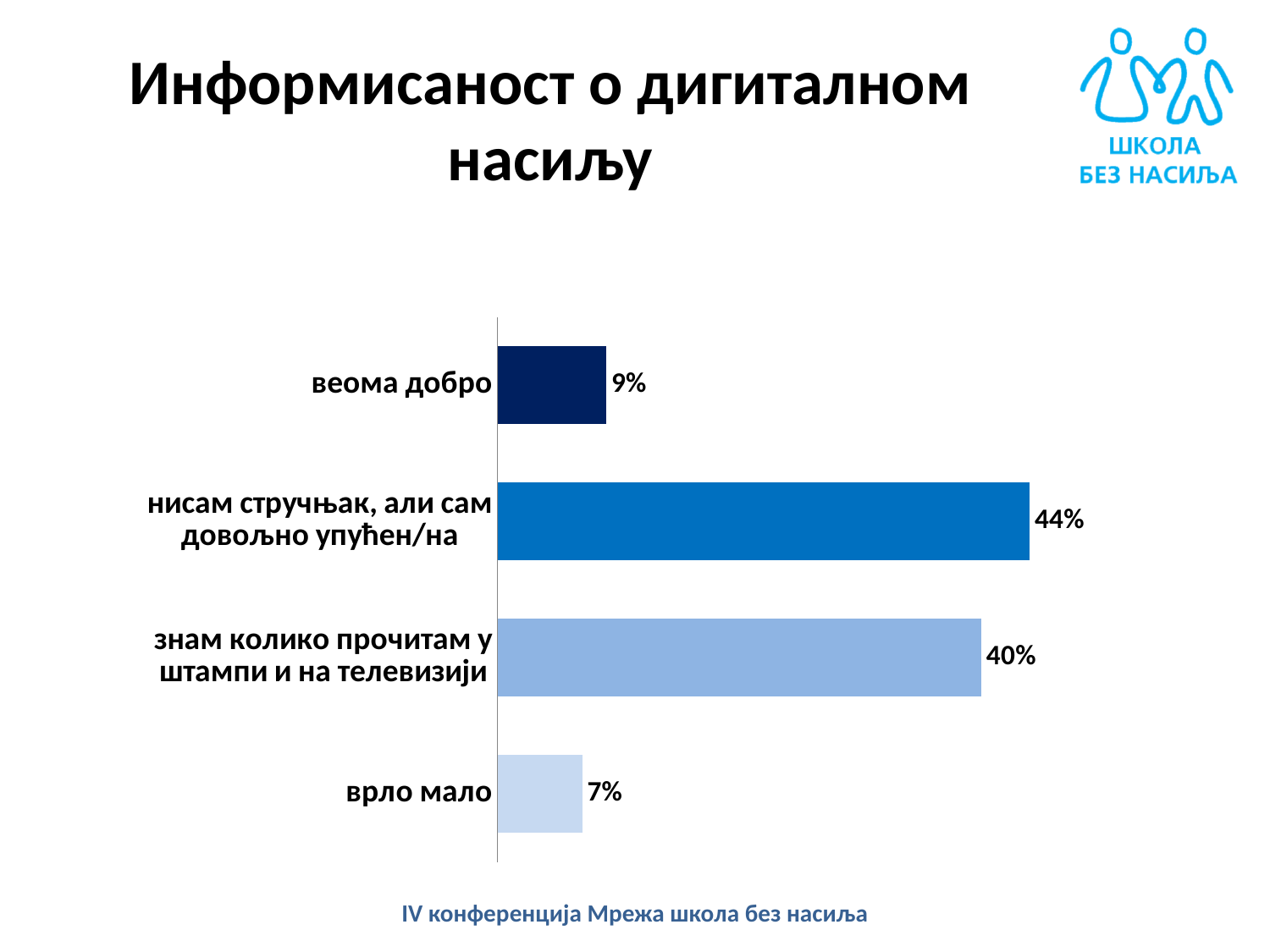
What is the difference between the values for "веома добро" and "врло мало"? 2% Which category has the lowest value? врло мало How many categories are shown in the chart? 4 What is the title of the slide? Информисаност о дигиталном насиљу What is the difference between the values for "нисам стручњак, али сам довољно упућен/на" and "знам колико прочитам у штампи и на телевизији"? 4% What is the value for "нисам стручњак, али сам довољно упућен/на"? 44% What is the value for "веома добро"? 9% Which is larger, the value for "веома добро" or the value for "врло мало"? веома добро Which category has the highest value? нисам стручњак, али сам довољно упућен/на What is the value for "врло мало"? 7% What kind of chart is shown on the slide? bar chart What is the value for "знам колико прочитам у штампи и на телевизији"? 40%